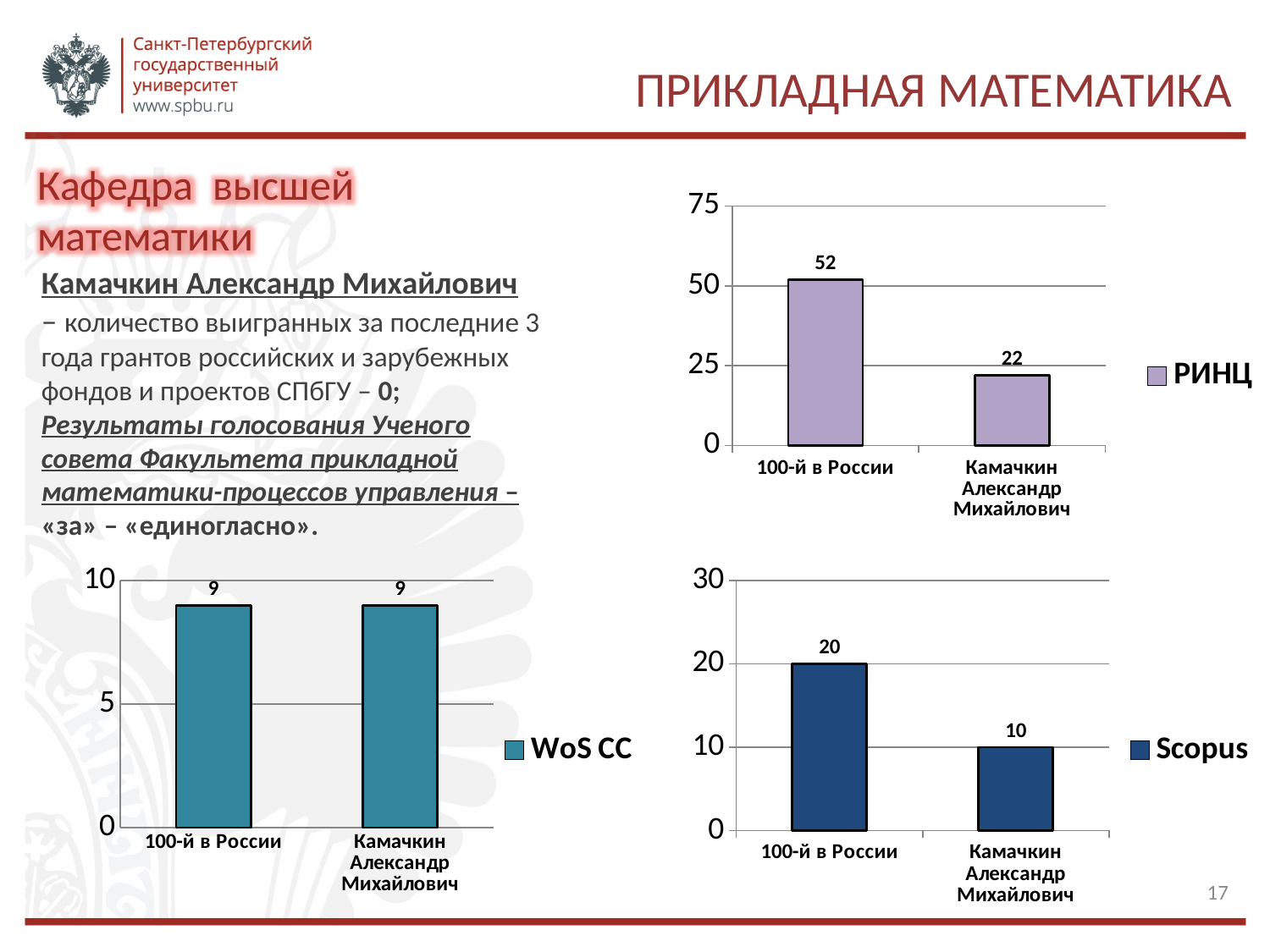
In the РИНЦ chart, which category has the highest value? 100-й в России In the WoS CC chart, what is the difference between the values for 100-й в России and Камачкин Александр Михайлович? 0 In the Scopus chart, what is the value for Камачкин Александр Михайлович? 10 In the Scopus chart, what is the value for 100-й в России? 20 In the РИНЦ chart, what is the value for 100-й в России? 52 In the РИНЦ chart, what is the difference between the values for 100-й в России and Камачкин Александр Михайлович? 30 In the РИНЦ chart, what is the value for Камачкин Александр Михайлович? 22 How many series does the legend of the Scopus chart list? 1 What kind of chart is the WoS CC chart? bar chart In the Scopus chart, which category has the lowest value? Камачкин Александр Михайлович In the WoS CC chart, what is the value for Камачкин Александр Михайлович? 9 In the Scopus chart, how many categories are shown? 2